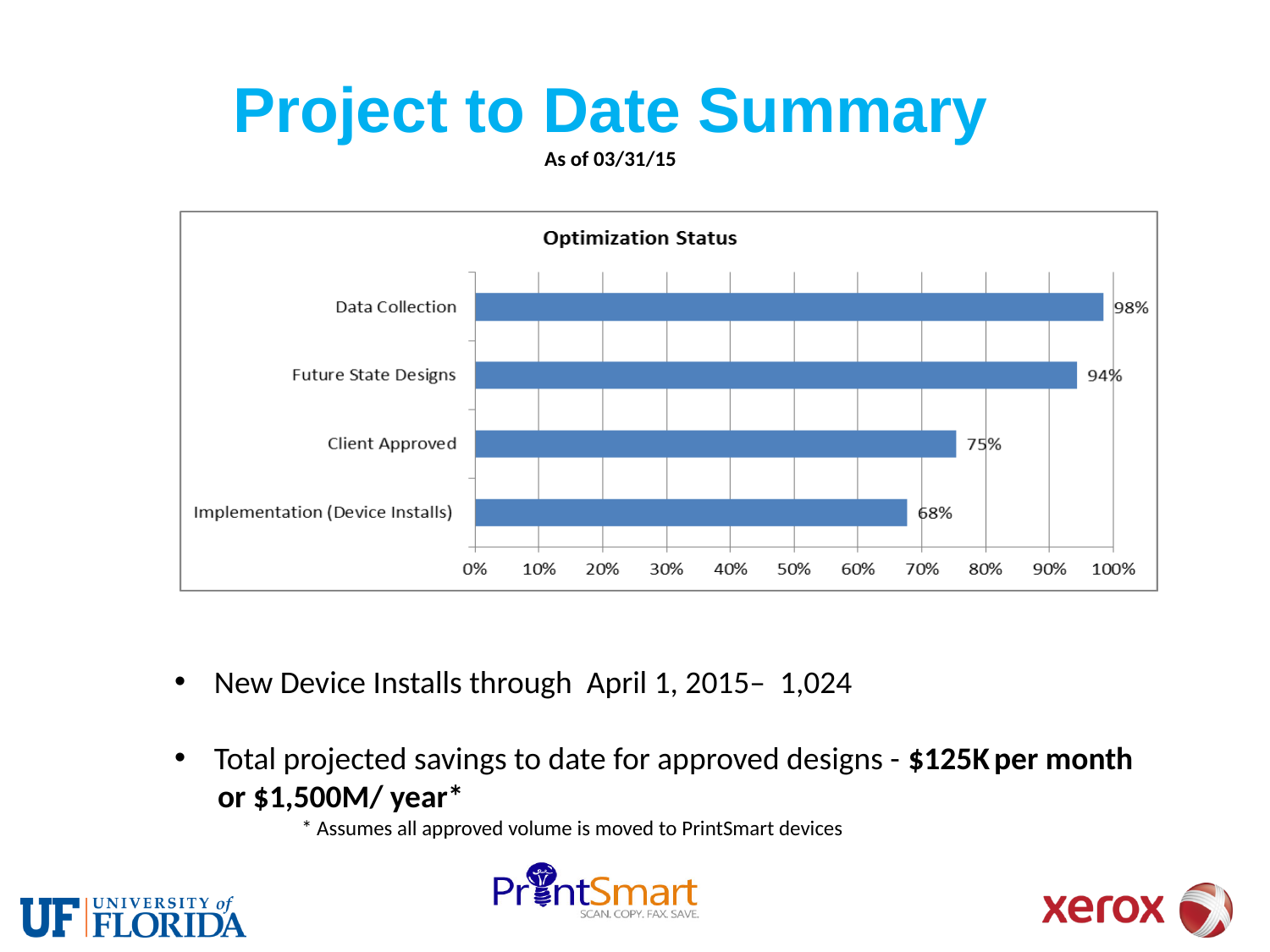
What is the value for Client Approved in the Optimization Status chart? 75% What kind of chart is the Optimization Status chart? Bar chart Is the value for Client Approved greater or less than 70%? greater What is the difference between the values for Data Collection and Implementation (Device Installs)? 30% Which category has the lowest value in the Optimization Status chart? Implementation (Device Installs) How many categories are shown in the Optimization Status chart? 4 What is the value for Data Collection in the Optimization Status chart? 98% What is the difference between the values for Future State Designs and Client Approved? 19% What is the value for Future State Designs in the Optimization Status chart? 94% Which category has the highest value in the Optimization Status chart? Data Collection What is the value for Implementation (Device Installs) in the Optimization Status chart? 68% Which is larger, the value for Client Approved or the value for Implementation (Device Installs)? Client Approved